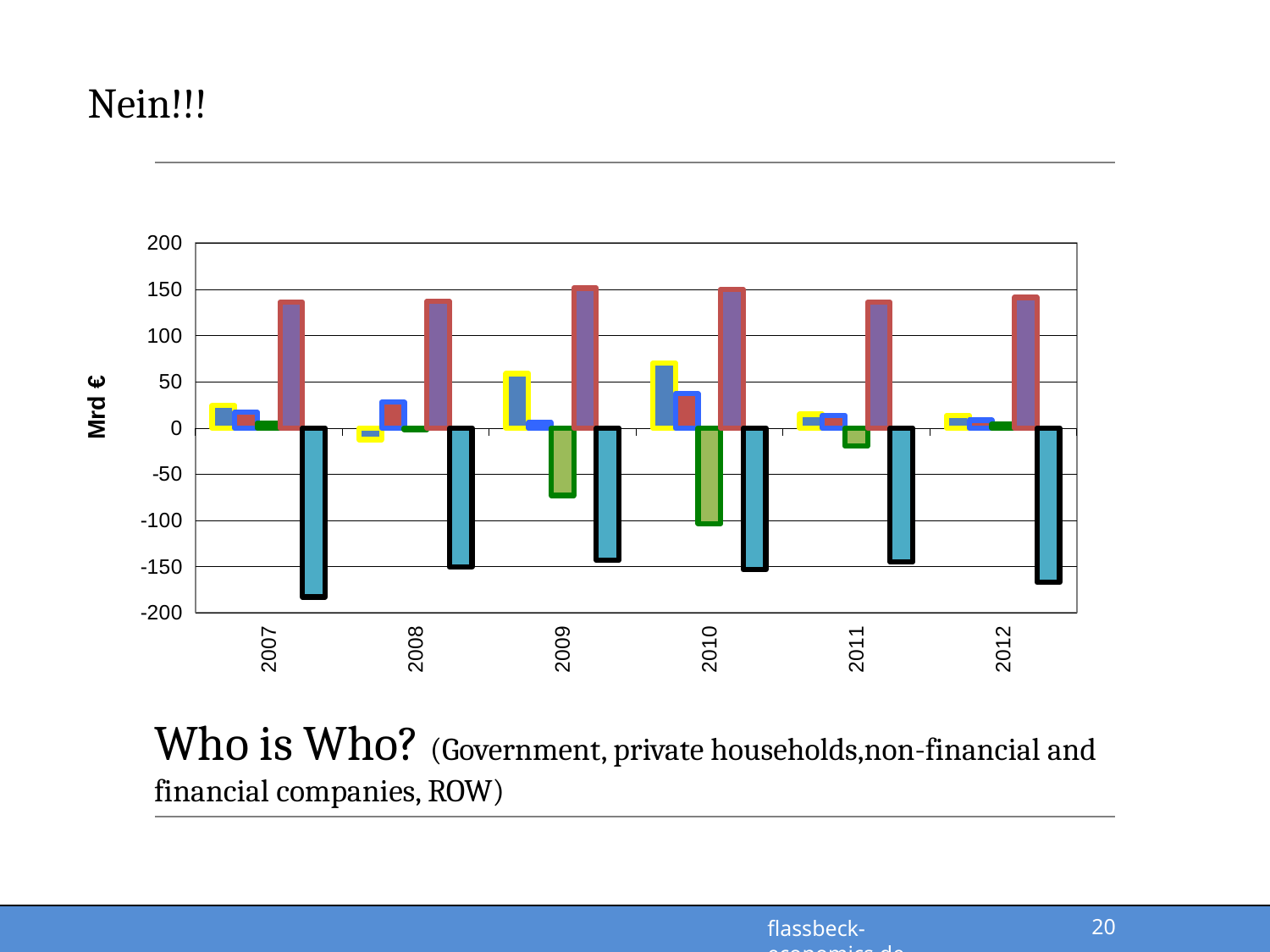
Is the value of the teal bar with the black outline for 2012 greater or less than -150? less What is the label on the vertical axis of the chart? Mrd € How many years are shown on the x axis of the chart? 6 Is the value of the teal bar with the black outline for 2007 greater or less than -150? less What kind of chart is shown on the slide? bar chart In which year does the teal bar with the black outline reach its lowest value? 2007 Is the value of the green bar for 2009 greater or less than -50? less What is the first year shown on the x axis of the chart? 2007 Which is lower, the green bar for 2009 or the green bar for 2010? 2010 In which year is the yellow-outlined blue bar the tallest? 2010